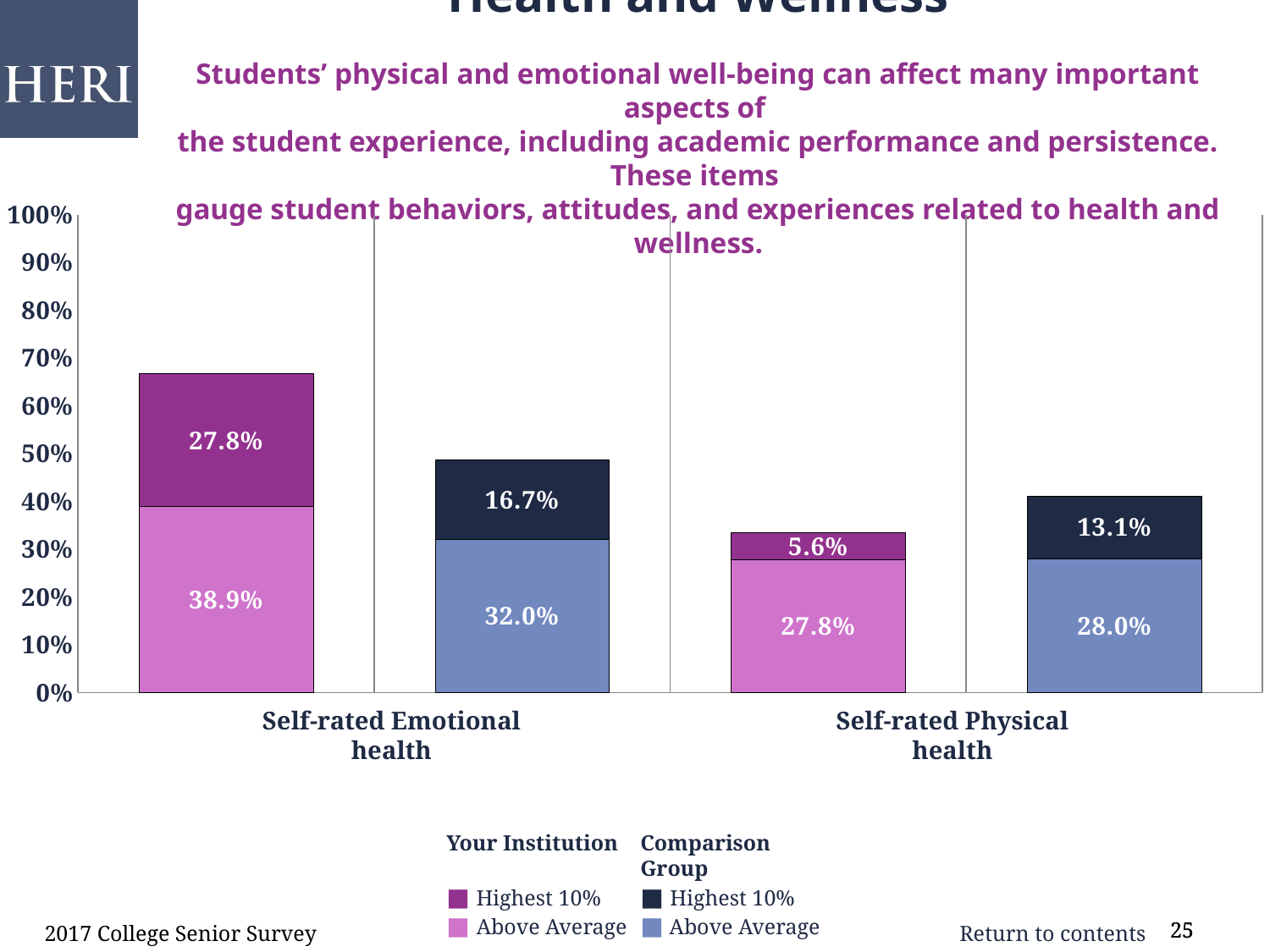
Which of the four stacked bars is the tallest? Your Institution, Self-rated Emotional health What percentage of the Comparison Group rated their emotional health in the Highest 10%? 16.7% What is the difference between the Your Institution and Comparison Group Highest 10% values for Self-rated Emotional health? 11.1% What type of chart is shown on the slide? Stacked bar chart What is the total height of the Comparison Group stacked bar for Self-rated Physical health? 41.1% How many entries does the legend list? 4 What percentage of the Comparison Group rated their physical health as Above Average? 28.0% What percentage of Your Institution students rated their emotional health as Above Average? 38.9% For Self-rated Physical health, which group has the larger Highest 10% value, Your Institution or the Comparison Group? Comparison Group What percentage of Your Institution students rated their physical health in the Highest 10%? 5.6% Is the total of the Your Institution bar for Self-rated Physical health greater or less than 40%? less What is the total height of the Your Institution stacked bar for Self-rated Emotional health? 66.7%